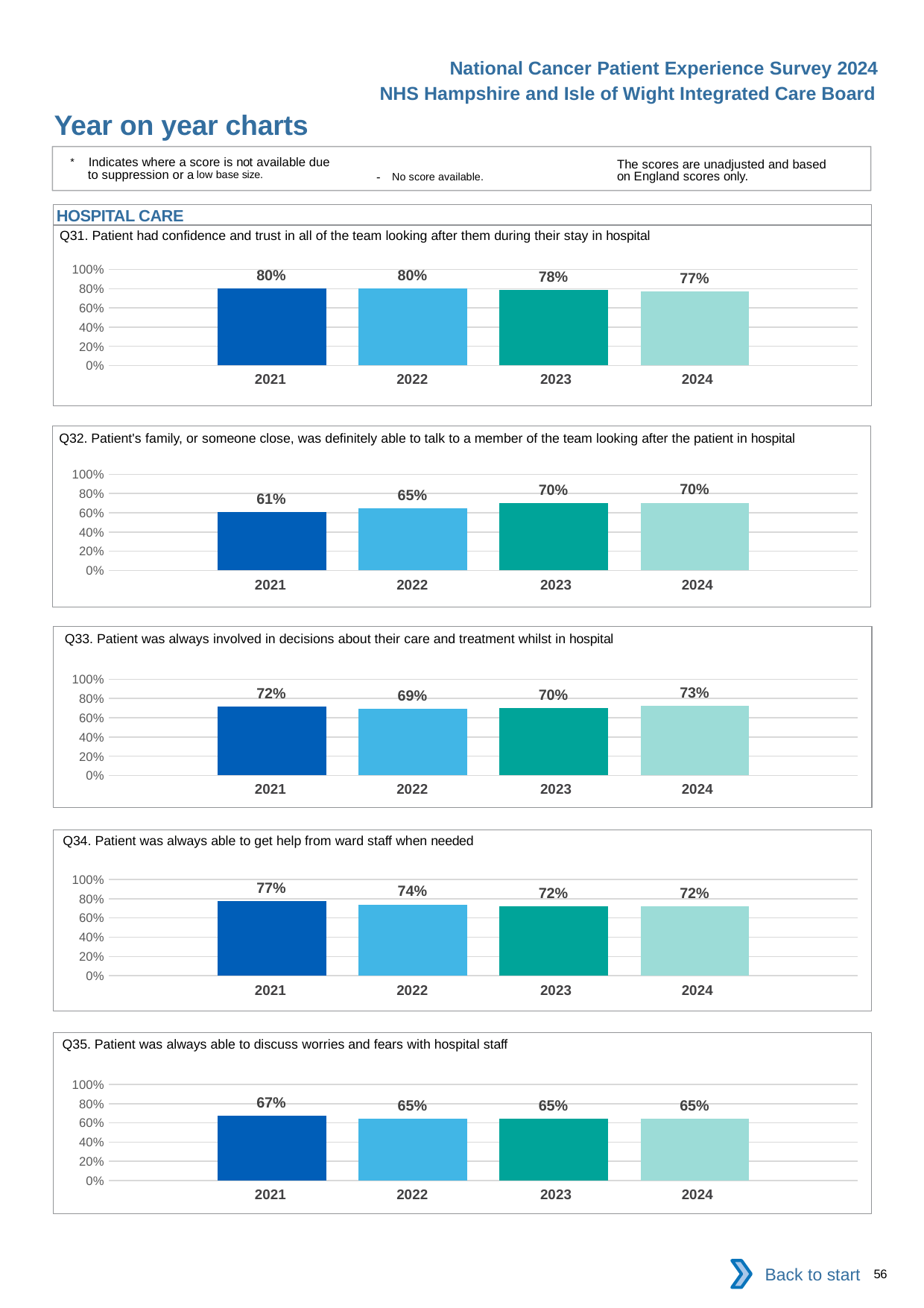
In the Q33 chart, what is the value for 2022? 69% In the Q33 chart, which year has the highest value? 2024 In the Q32 chart, which year has the lowest value? 2021 How many years are shown on the x axis of the Q31 chart? 4 In the Q31 chart, is the value for 2024 greater or less than 60%? greater In the Q32 chart, what is the difference between the 2024 value and the 2021 value? 9% In the Q34 chart, what is the difference between the 2021 value and the 2022 value? 3% In the Q31 chart, what is the value for 2023? 78% In the Q35 chart, do the values rise or fall from 2021 to 2022? fall What kind of chart is the Q32 chart? bar chart In the Q34 chart, is the value for 2021 larger or smaller than the value for 2024? larger In the Q35 chart, what is the value for 2021? 67%